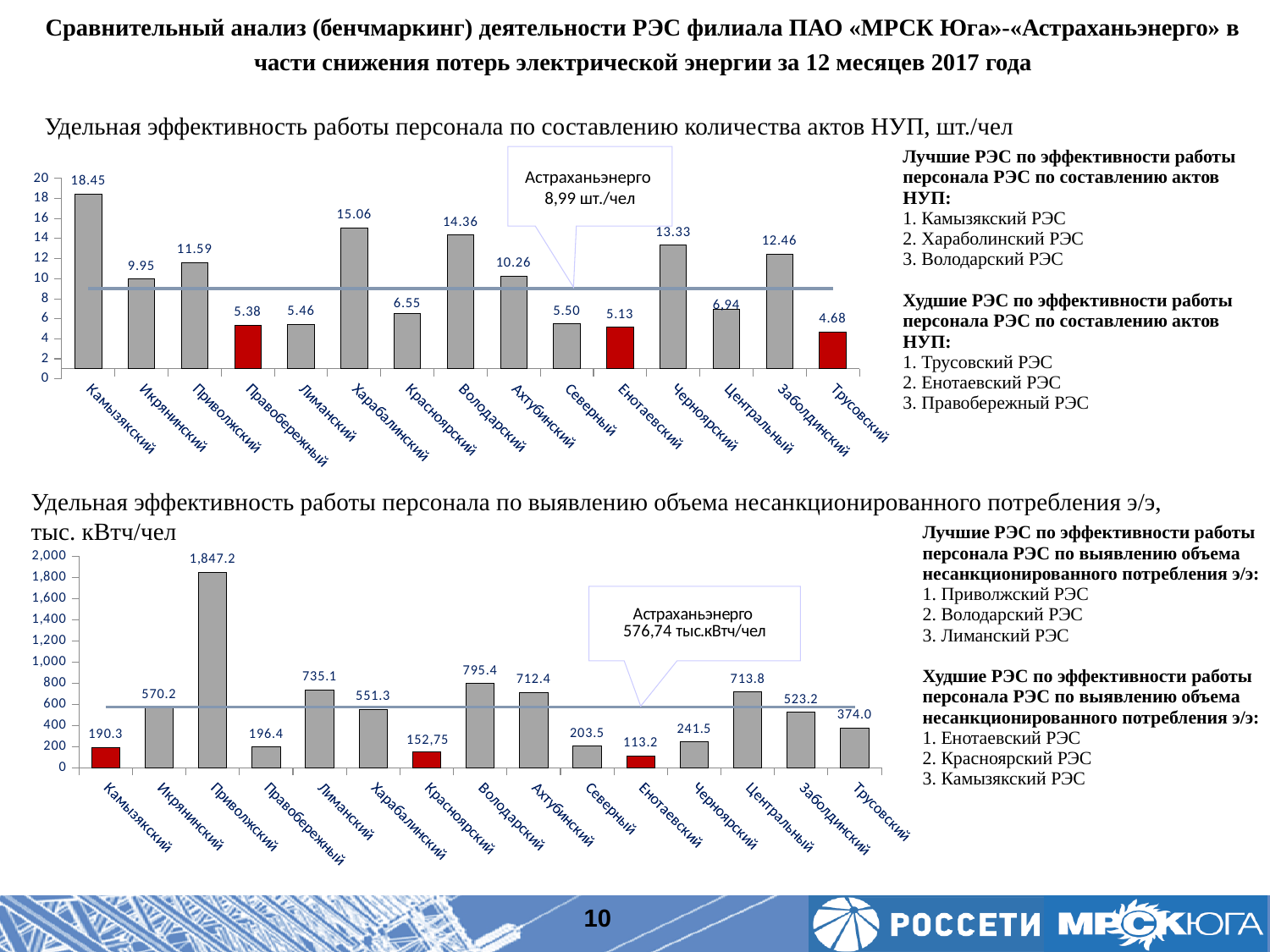
In the bottom chart, which category has the highest value? Приволжский In the bottom chart, what is the value for Трусовский? 374.0 In the bottom chart, which category has the lowest value? Енотаевский In the top chart, which category has the lowest value? Трусовский In the bottom chart, what is the difference between the values for Володарский and Ахтубинский? 83.0 In the top chart, how many categories are shown on the x axis? 15 In the top chart, what is the difference between the values for Харабалинский and Володарский? 0.70 In the top chart, what is the value for Камызякский? 18.45 In the bottom chart, what is the value for Приволжский? 1,847.2 In the top chart, what value is shown in the callout for Астраханьэнерго? 8,99 шт./чел In the top chart, which is larger: the value for Черноярский or the value for Заболдинский? Черноярский What type of chart is the top chart? bar chart